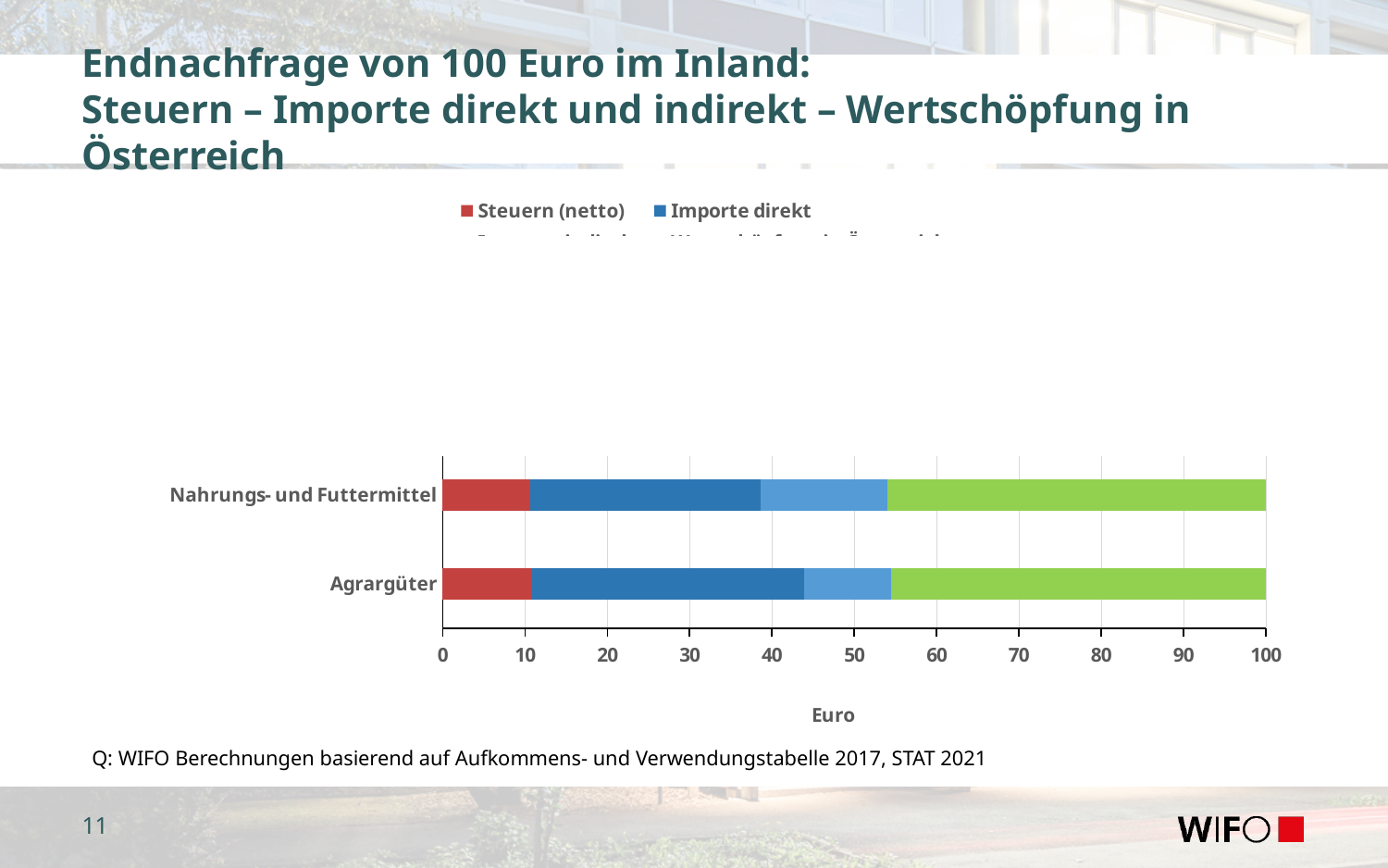
What is the label of the x axis? Euro What colour represents Steuern (netto) in the legend? Red What is the highest value shown on the x axis? 100 Is the Steuern (netto) segment for Agrargüter greater or less than 20? less How many categories are plotted on the chart? 2 Which category has the larger Importe direkt segment, Nahrungs- und Futtermittel or Agrargüter? Agrargüter What is the total of the stacked bar for Nahrungs- und Futtermittel? 100 What kind of chart is shown on the slide? Stacked bar chart Is the Importe direkt segment for Agrargüter greater or less than 40? less Is the Importe direkt segment for Nahrungs- und Futtermittel greater or less than 40? less What is the total of the stacked bar for Agrargüter? 100